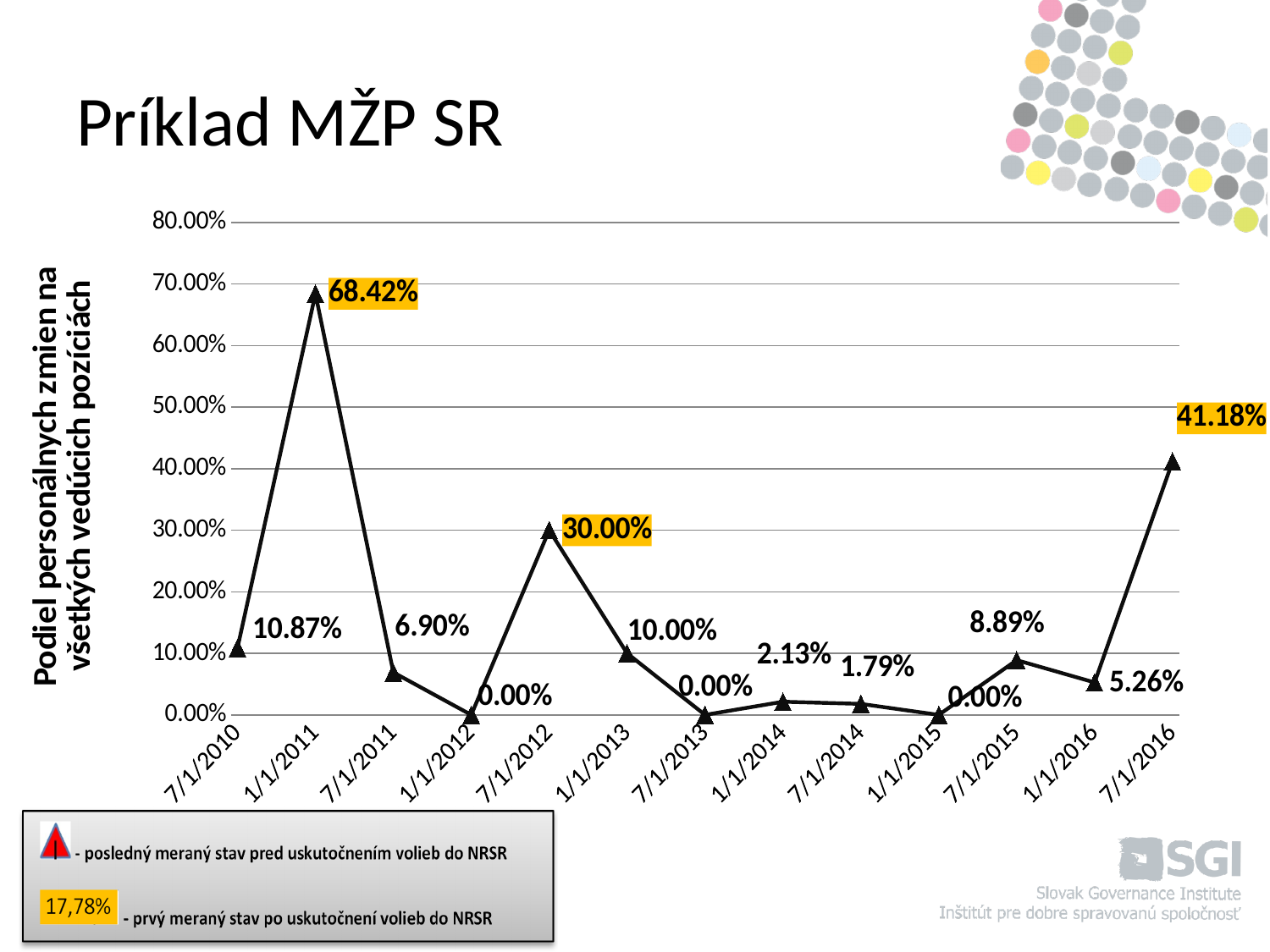
What is the value for 7/1/2016? 41.18% Which date has the highest value? 1/1/2011 What is the value for 1/1/2011? 68.42% Does the value rise or fall from 1/1/2016 to 7/1/2016? Rise What kind of chart is shown on the slide? Line chart Which is larger, the value for 7/1/2010 or the value for 7/1/2011? 7/1/2010 What is the difference between the values for 1/1/2011 and 7/1/2016? 27.24% How many data points are plotted on the chart? 13 What is the lowest value shown on the chart? 0.00% What is the value for 7/1/2012? 30.00% How many data labels are highlighted in yellow on the chart? 3 What is the value for 7/1/2015? 8.89%